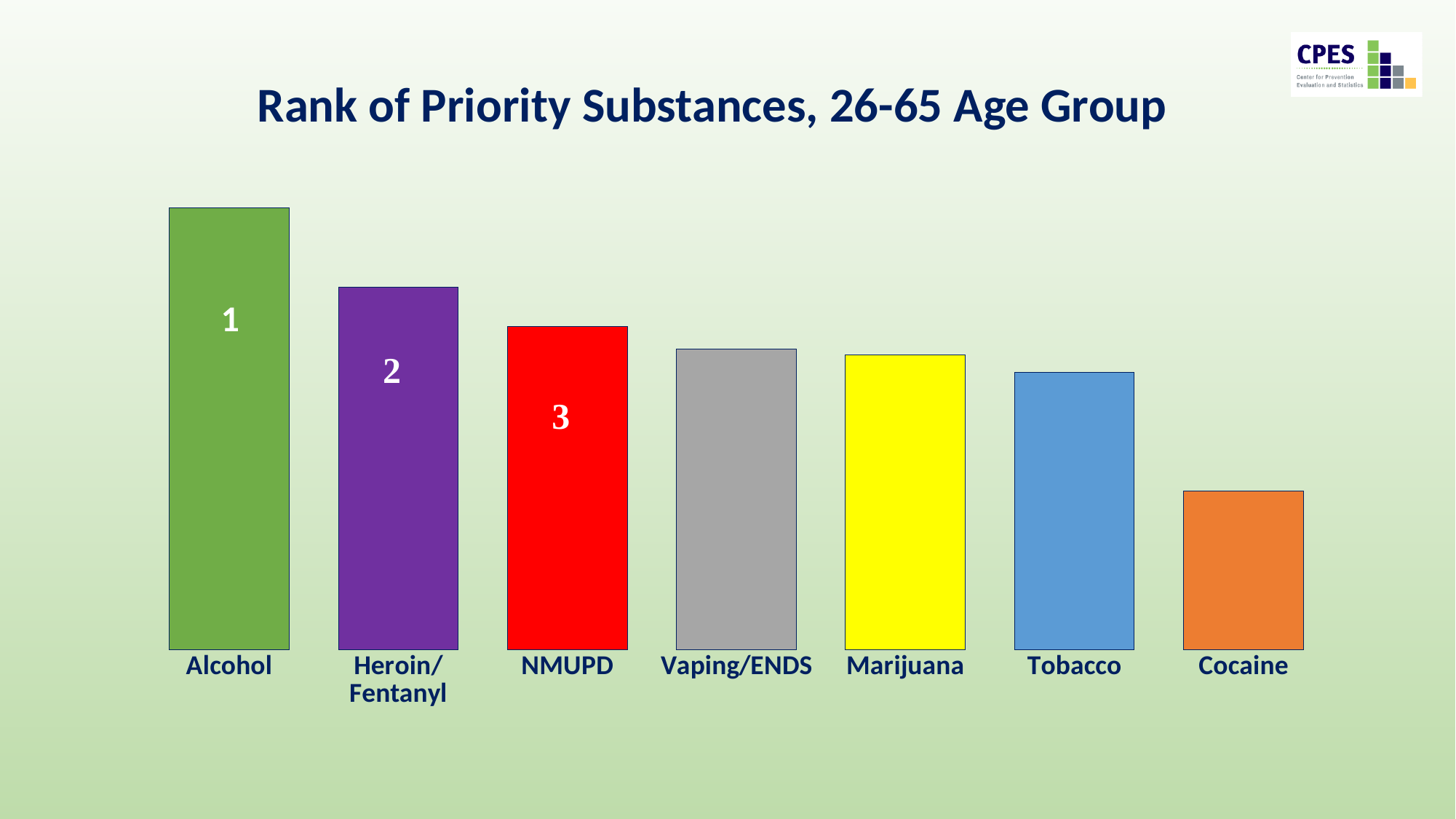
Which substance has the shortest bar in the chart? Cocaine How many substances are shown as bars in the chart? 7 What rank number is printed on the Alcohol bar? 1 Which substance has the tallest bar in the chart? Alcohol What rank number is printed on the NMUPD bar? 3 Do the bar heights rise or fall from left to right across the chart? fall What is the title of the chart? Rank of Priority Substances, 26-65 Age Group What rank number is printed on the Heroin/Fentanyl bar? 2 Which substance is ranked 3 in the chart? NMUPD What kind of chart is shown on the slide? bar chart Which bar is taller, Cocaine or NMUPD? NMUPD Which bar is taller, Heroin/Fentanyl or Tobacco? Heroin/Fentanyl